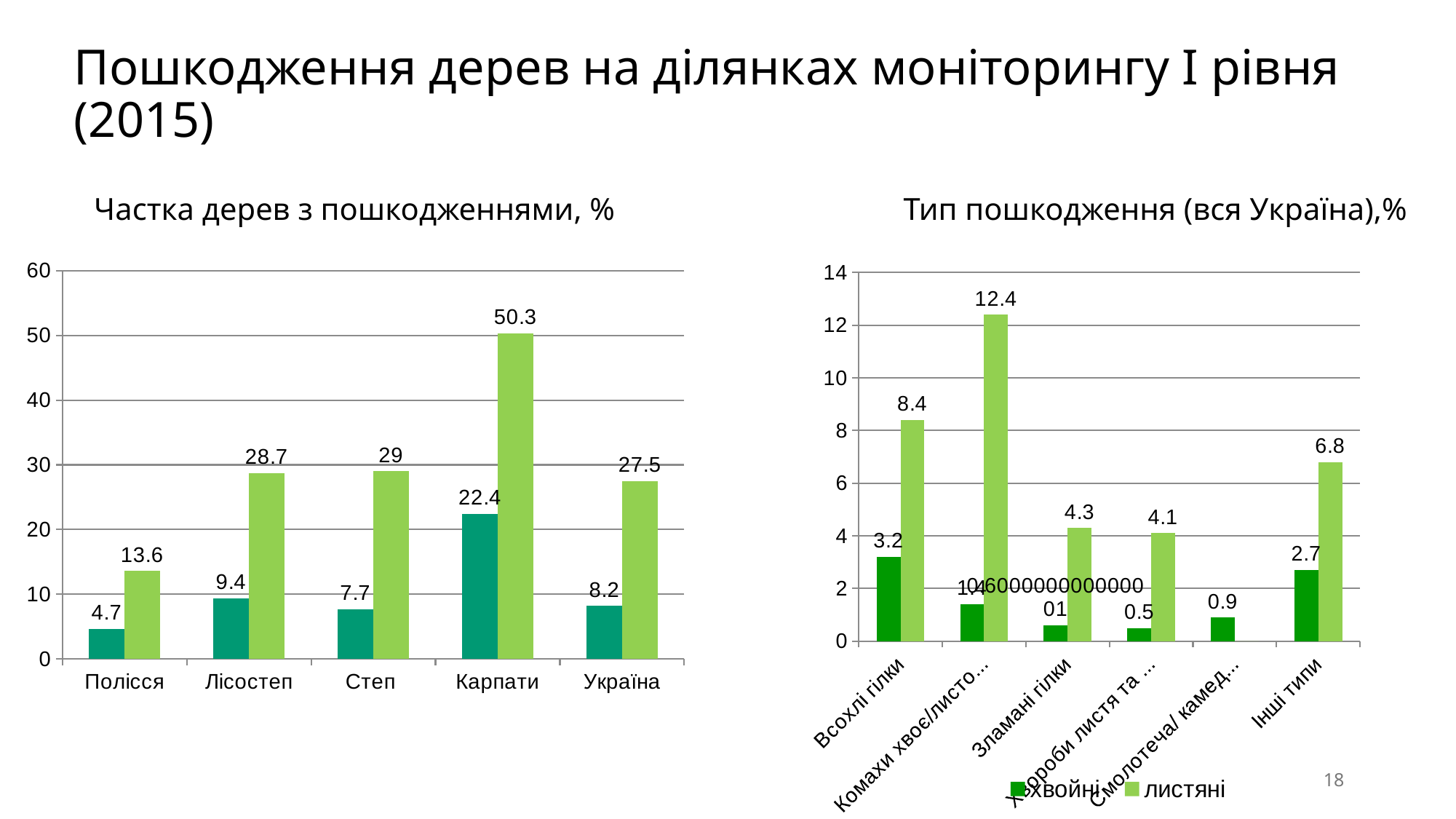
In the chart 'Частка дерев з пошкодженнями, %', which category has the highest lighter green bar? Карпати In the chart 'Частка дерев з пошкодженнями, %', what is the value of the darker bar for Полісся? 4.7 What kind of chart is 'Частка дерев з пошкодженнями, %'? bar chart In the chart 'Тип пошкодження (вся Україна),%', what is the difference between the листяні value (6.8) and the хвойні value (2.7) for Інші типи? 4.1 In the chart 'Частка дерев з пошкодженнями, %', which category has the lowest darker bar? Полісся How many categories are shown on the x axis of the chart 'Частка дерев з пошкодженнями, %'? 5 In the chart 'Тип пошкодження (вся Україна),%', what is the листяні value for Всохлі гілки? 8.4 In the chart 'Частка дерев з пошкодженнями, %', what is the difference between the lighter bar (27.5) and the darker bar (8.2) for Україна? 19.3 In the chart 'Тип пошкодження (вся Україна),%', which series has the larger value for Всохлі гілки, хвойні or листяні? листяні In the chart 'Частка дерев з пошкодженнями, %', what is the value of the lighter green bar for Карпати? 50.3 How many series does the legend of the chart 'Тип пошкодження (вся Україна),%' list? 2 In the chart 'Тип пошкодження (вся Україна),%', what is the хвойні value for Інші типи? 2.7